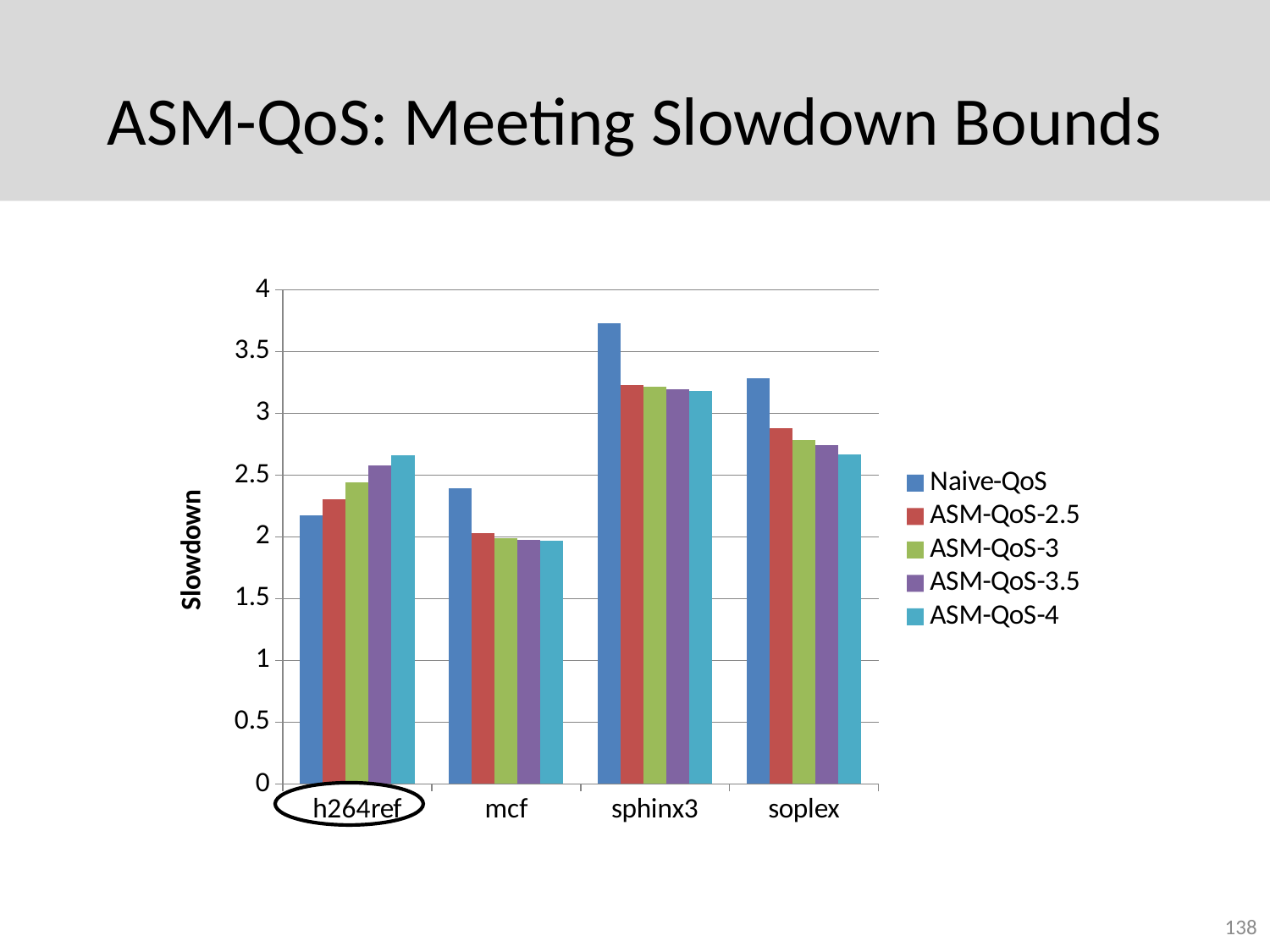
Is the Naive-QoS value for sphinx3 greater or less than 3.5? greater For h264ref, do the bars rise or fall going from Naive-QoS to ASM-QoS-4? rise Which has the larger ASM-QoS-2.5 value: sphinx3 or soplex? sphinx3 Which category has the lowest Naive-QoS slowdown? h264ref Is the Naive-QoS value for soplex greater or less than 3? greater How many categories are shown on the x axis? 4 What is the label on the y axis? Slowdown Which category has the highest Naive-QoS slowdown? sphinx3 How many series does the legend list? 5 For mcf, which is larger: the Naive-QoS value or the ASM-QoS-4 value? Naive-QoS What kind of chart is shown on the slide? bar chart